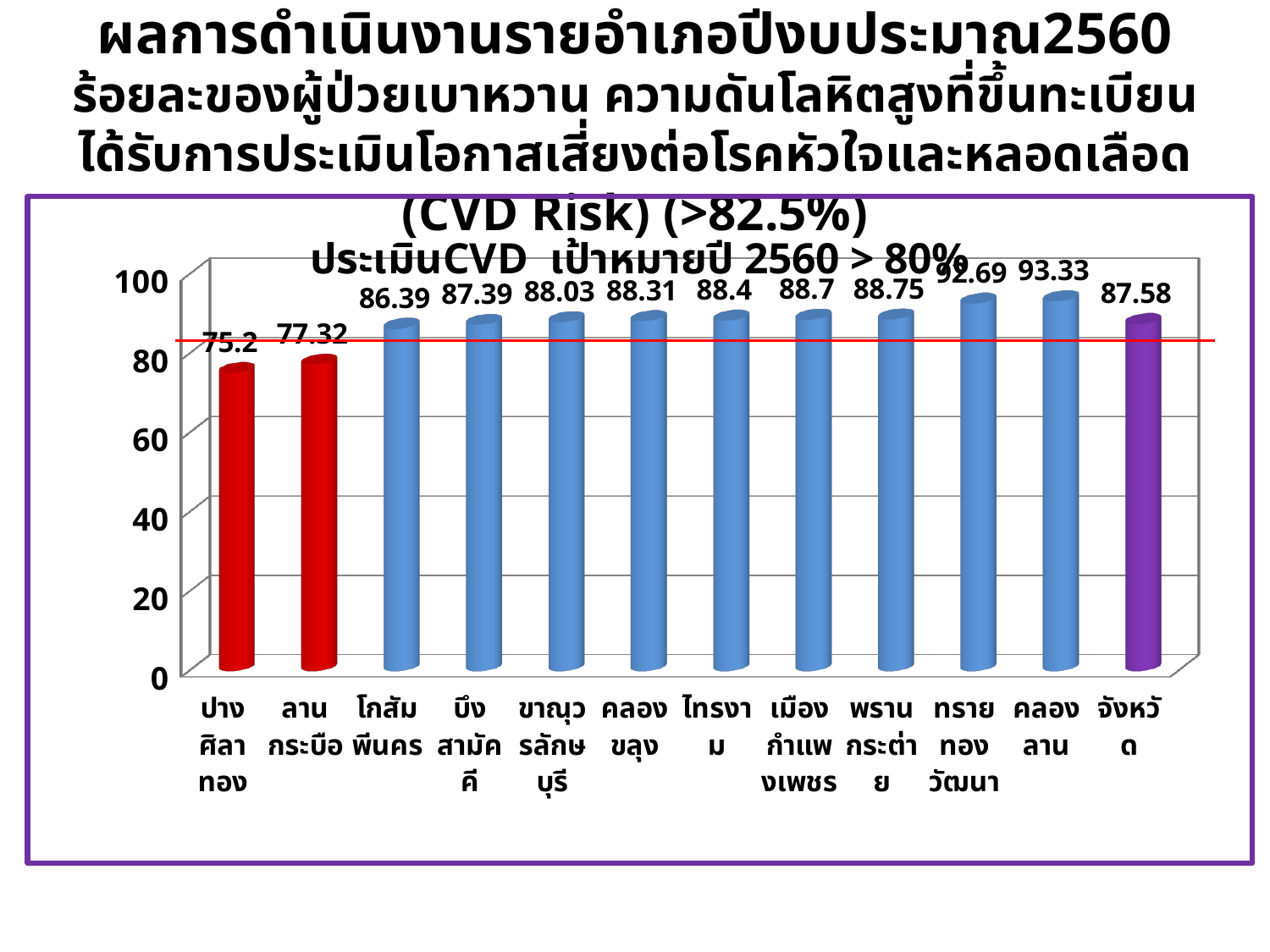
Is the value for ปางศิลาทอง greater or less than 80? less What is the difference between the values for คลองลาน and ปางศิลาทอง? 18.13 What is the value for จังหวัด? 87.58 What kind of chart is shown on the slide? bar chart What is the value for คลองขลุง? 88.31 What is the value for ลานกระบือ? 77.32 Which category has the lowest value? ปางศิลาทอง Which is larger, the value for ทรายทองวัฒนา or the value for โกสัมพีนคร? ทรายทองวัฒนา How many bars are coloured red? 2 Which category has the highest value? คลองลาน What is the title of the chart? ประเมินCVD เป้าหมายปี 2560 > 80% How many categories are shown on the x axis? 12